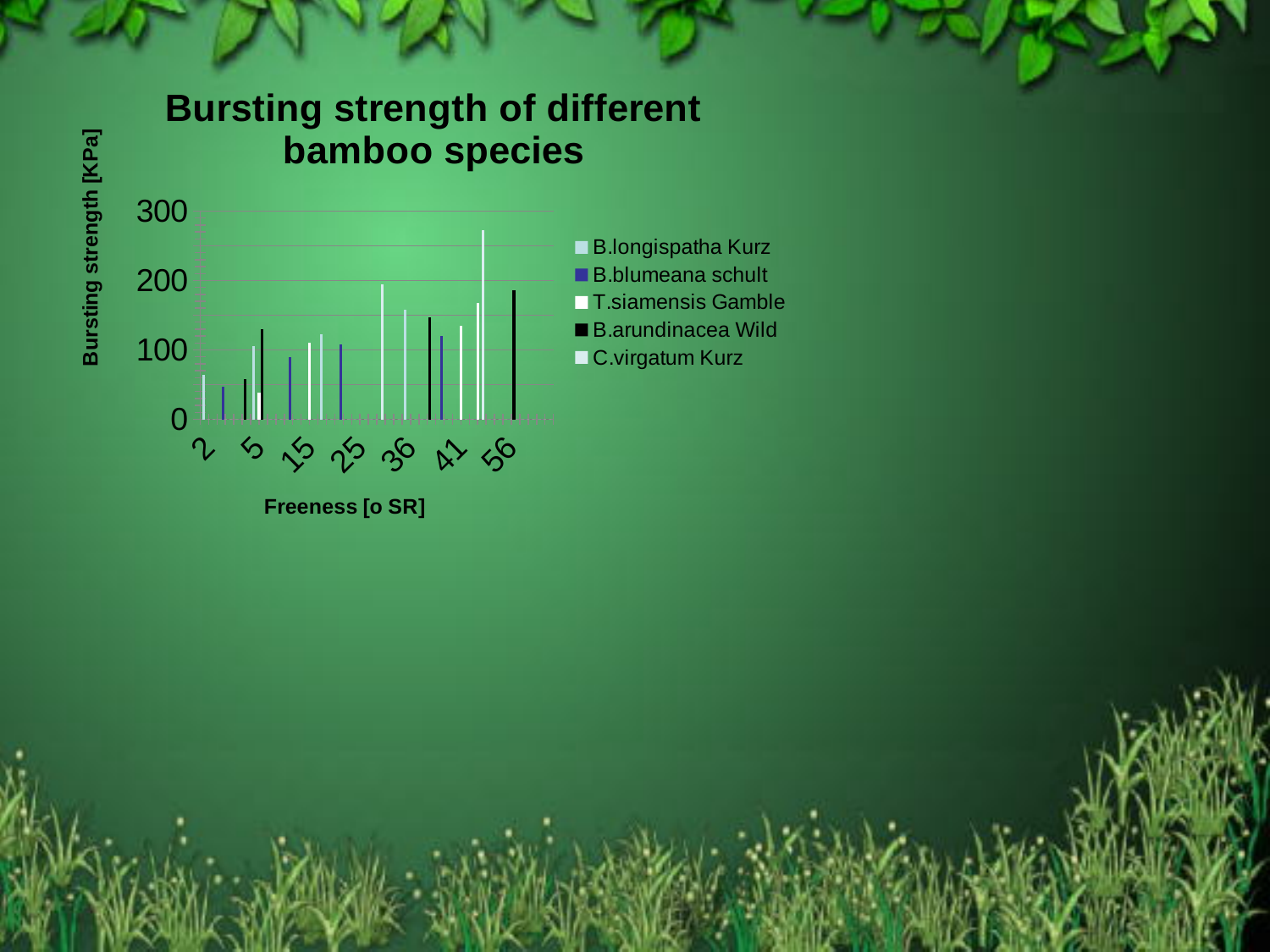
Is the tallest bar at freeness 41 greater or less than 100? greater What kind of chart is shown on the slide? bar chart Is the tallest bar at freeness 36 greater or less than 100? greater Is the tallest bar at freeness 5 greater or less than 200? less What is the label of the x axis? Freeness [o SR] How many series does the legend list? 5 What is the title of the chart? Bursting strength of different bamboo species